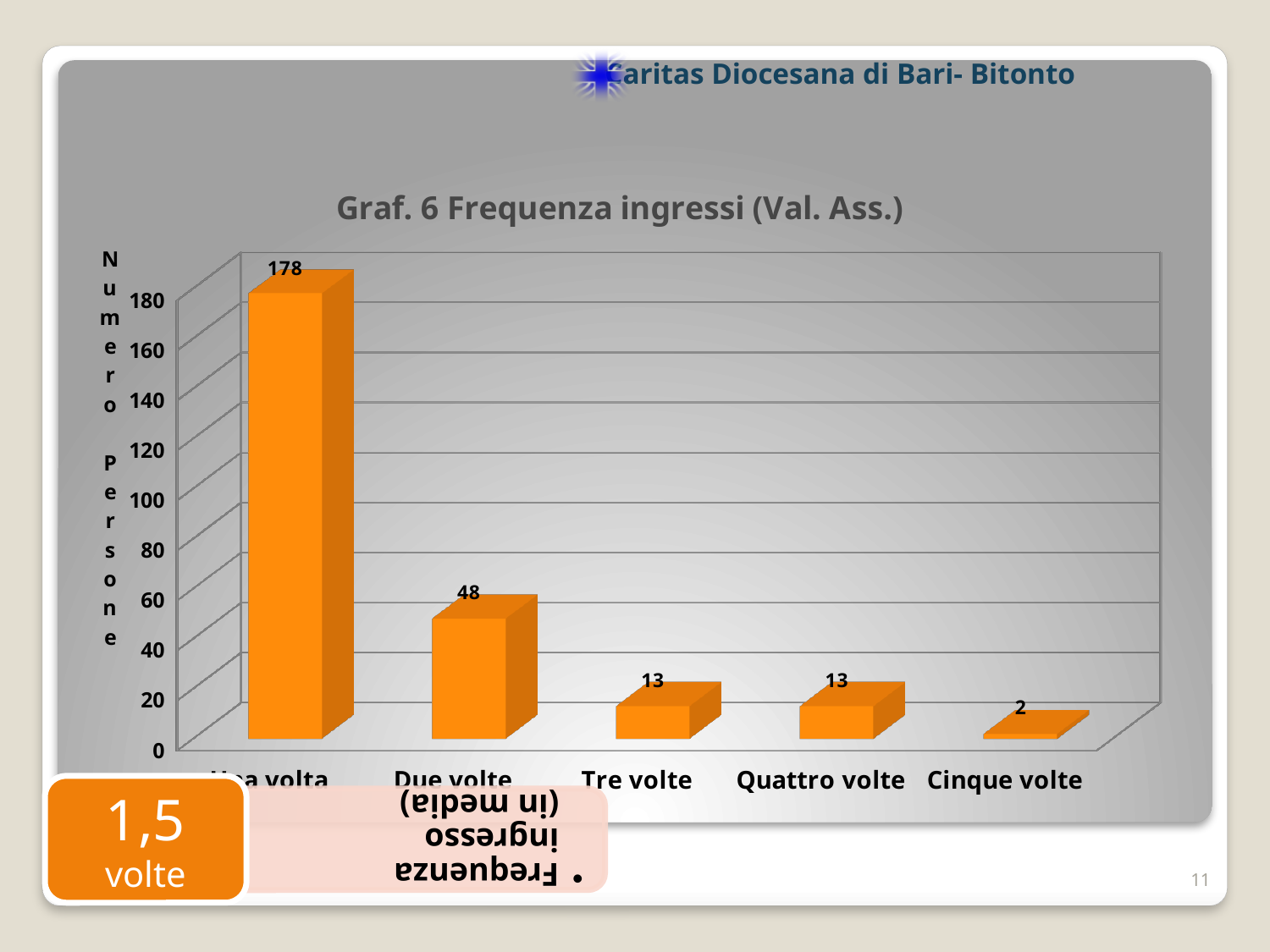
What is the value for Tre volte? 13 What is the value for Una volta? 178 Which is larger, the value for Due volte or the value for Quattro volte? Due volte What is the value for Cinque volte? 2 Which category has the lowest value? Cinque volte What is the value for Due volte? 48 What is the difference between the values for Una volta and Due volte? 130 Do the values rise or fall from left to right along the x axis? fall How many categories are shown on the x axis? 5 What is the title of the chart? Graf. 6 Frequenza ingressi (Val. Ass.) Which category has the highest value? Una volta What type of chart is shown on the slide? bar chart